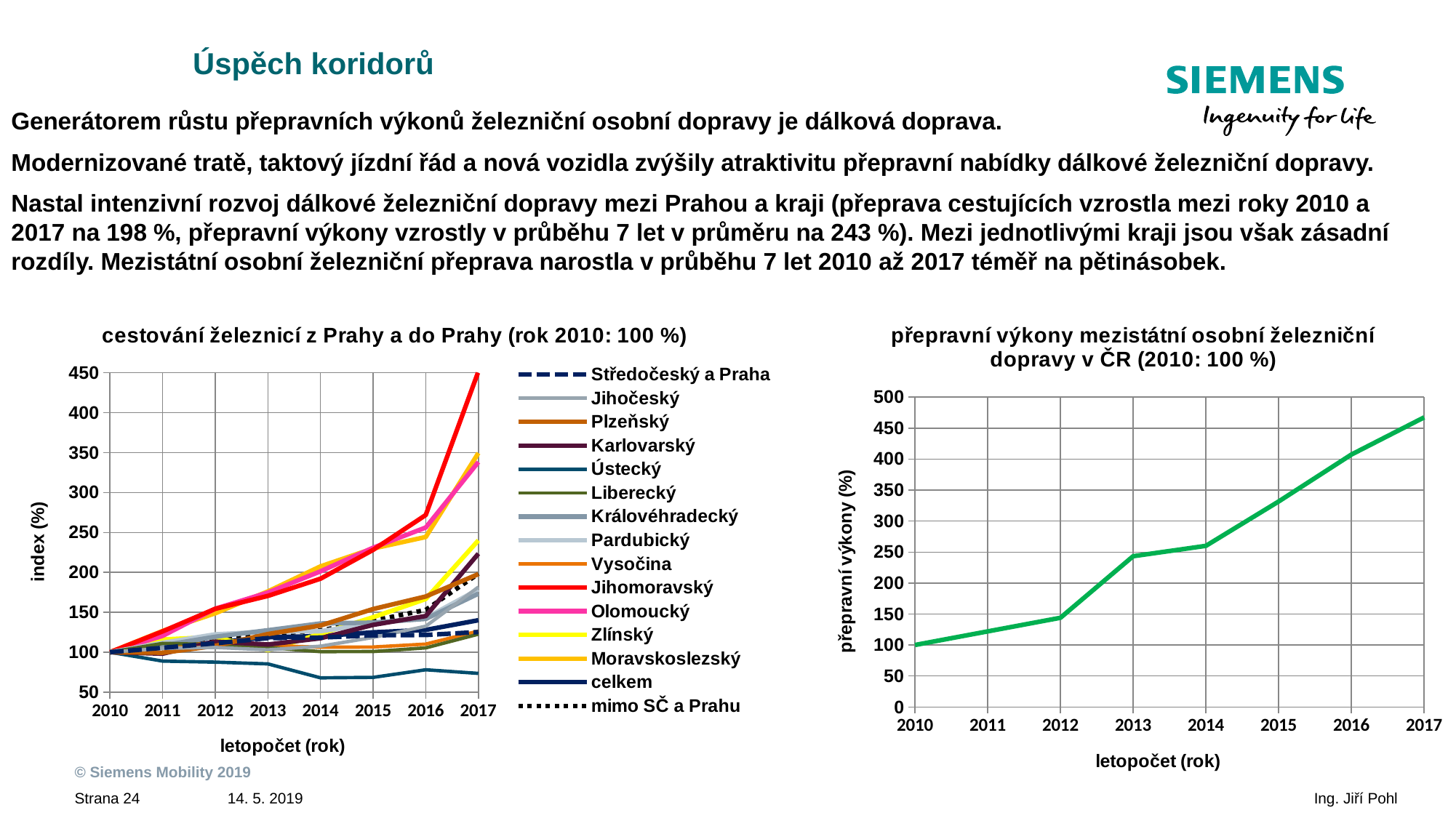
In the left chart 'cestování železnicí z Prahy a do Prahy', which series has the highest value in 2017? Jihomoravský In the right chart 'přepravní výkony mezistátní osobní železniční dopravy v ČR', do the values rise or fall from 2010 to 2017? rise In the left chart 'cestování železnicí z Prahy a do Prahy', is the value for Jihomoravský in 2017 greater or less than 400? greater In the left chart 'cestování železnicí z Prahy a do Prahy', is the value for Ústecký in 2017 greater or less than 100? less What type of chart is the left chart titled 'cestování železnicí z Prahy a do Prahy (rok 2010: 100 %)'? line chart How many years are plotted on the x axis of the right chart 'přepravní výkony mezistátní osobní železniční dopravy v ČR'? 8 In the right chart 'přepravní výkony mezistátní osobní železniční dopravy v ČR', is the value for 2017 greater or less than 400? greater How many series does the legend of the left chart 'cestování železnicí z Prahy a do Prahy' list? 15 In the left chart 'cestování železnicí z Prahy a do Prahy', which is larger in 2017: Jihomoravský or Ústecký? Jihomoravský In the right chart 'přepravní výkony mezistátní osobní železniční dopravy v ČR', what is the value for 2010? 100 In the left chart 'cestování železnicí z Prahy a do Prahy', which series has the lowest value in 2017? Ústecký